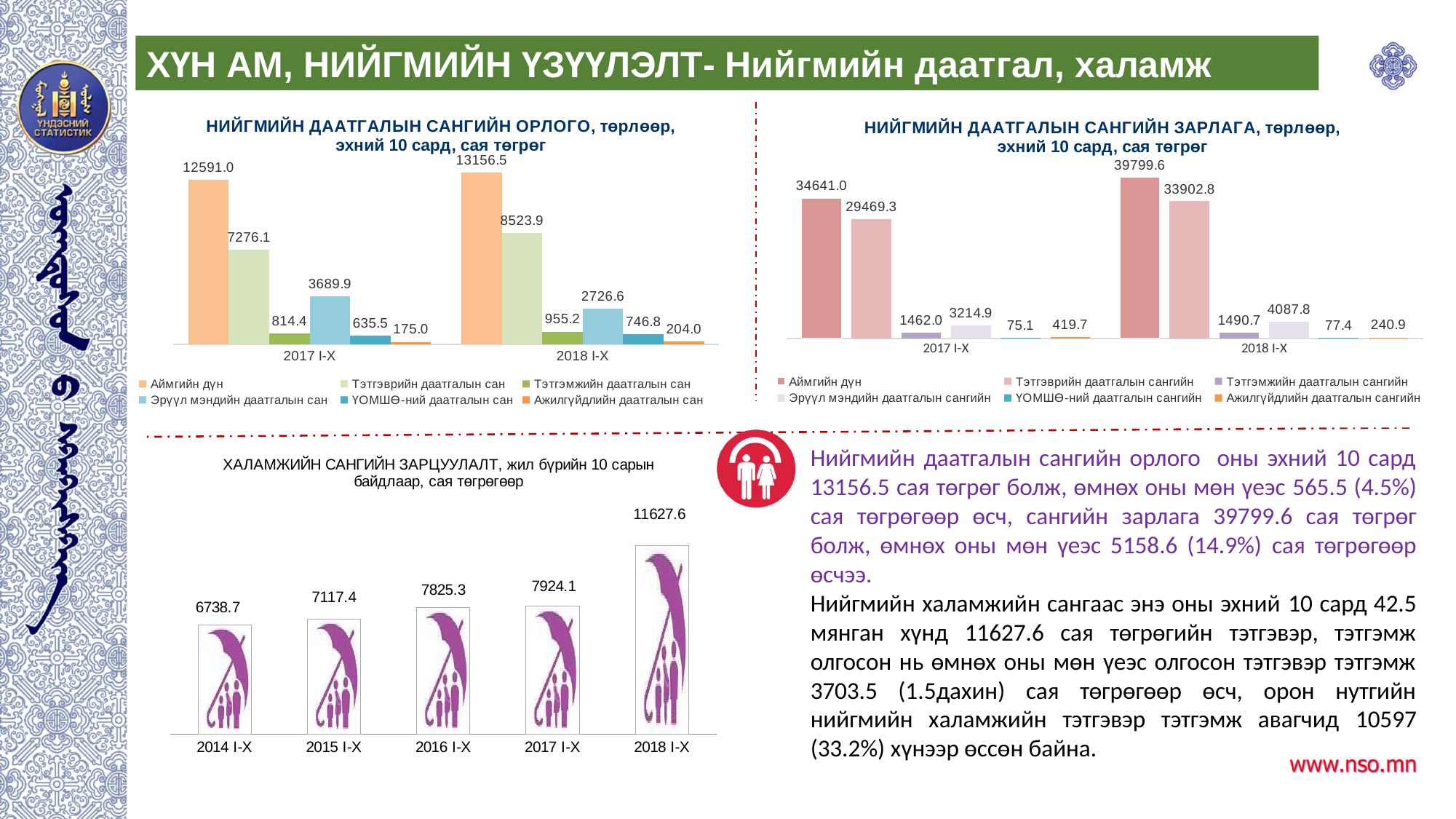
In the chart titled 'НИЙГМИЙН ДААТГАЛЫН САНГИЙН ОРЛОГО', by how much did Аймгийн дүн change from 2017 I-X to 2018 I-X? 565.5 In the chart titled 'НИЙГМИЙН ДААТГАЛЫН САНГИЙН ОРЛОГО', how many series does the legend list? 6 In the chart titled 'НИЙГМИЙН ДААТГАЛЫН САНГИЙН ЗАРЛАГА', what is the value of Тэтгэврийн даатгалын сангийн for 2018 I-X? 33902.8 In the chart titled 'НИЙГМИЙН ДААТГАЛЫН САНГИЙН ЗАРЛАГА', what is the value of ҮОМШӨ-ний даатгалын сангийн for 2017 I-X? 75.1 In the chart titled 'ХАЛАМЖИЙН САНГИЙН ЗАРЦУУЛАЛТ', do the values rise or fall from 2014 I-X to 2018 I-X? rise In the chart titled 'НИЙГМИЙН ДААТГАЛЫН САНГИЙН ЗАРЛАГА', is Ажилгүйдлийн даатгалын сангийн larger in 2017 I-X or 2018 I-X? 2017 I-X In the chart titled 'НИЙГМИЙН ДААТГАЛЫН САНГИЙН ОРЛОГО', what is the value of Аймгийн дүн for 2018 I-X? 13156.5 In the chart titled 'НИЙГМИЙН ДААТГАЛЫН САНГИЙН ЗАРЛАГА', what is the difference between Аймгийн дүн in 2018 I-X and 2017 I-X? 5158.6 In the chart titled 'ХАЛАМЖИЙН САНГИЙН ЗАРЦУУЛАЛТ', what is the value for 2016 I-X? 7825.3 In the chart titled 'ХАЛАМЖИЙН САНГИЙН ЗАРЦУУЛАЛТ', how many periods are shown on the x axis? 5 In the chart titled 'НИЙГМИЙН ДААТГАЛЫН САНГИЙН ОРЛОГО', which series has the lowest value in 2018 I-X? Ажилгүйдлийн даатгалын сан In the chart titled 'НИЙГМИЙН ДААТГАЛЫН САНГИЙН ОРЛОГО', what is the value of Эрүүл мэндийн даатгалын сан for 2017 I-X? 3689.9